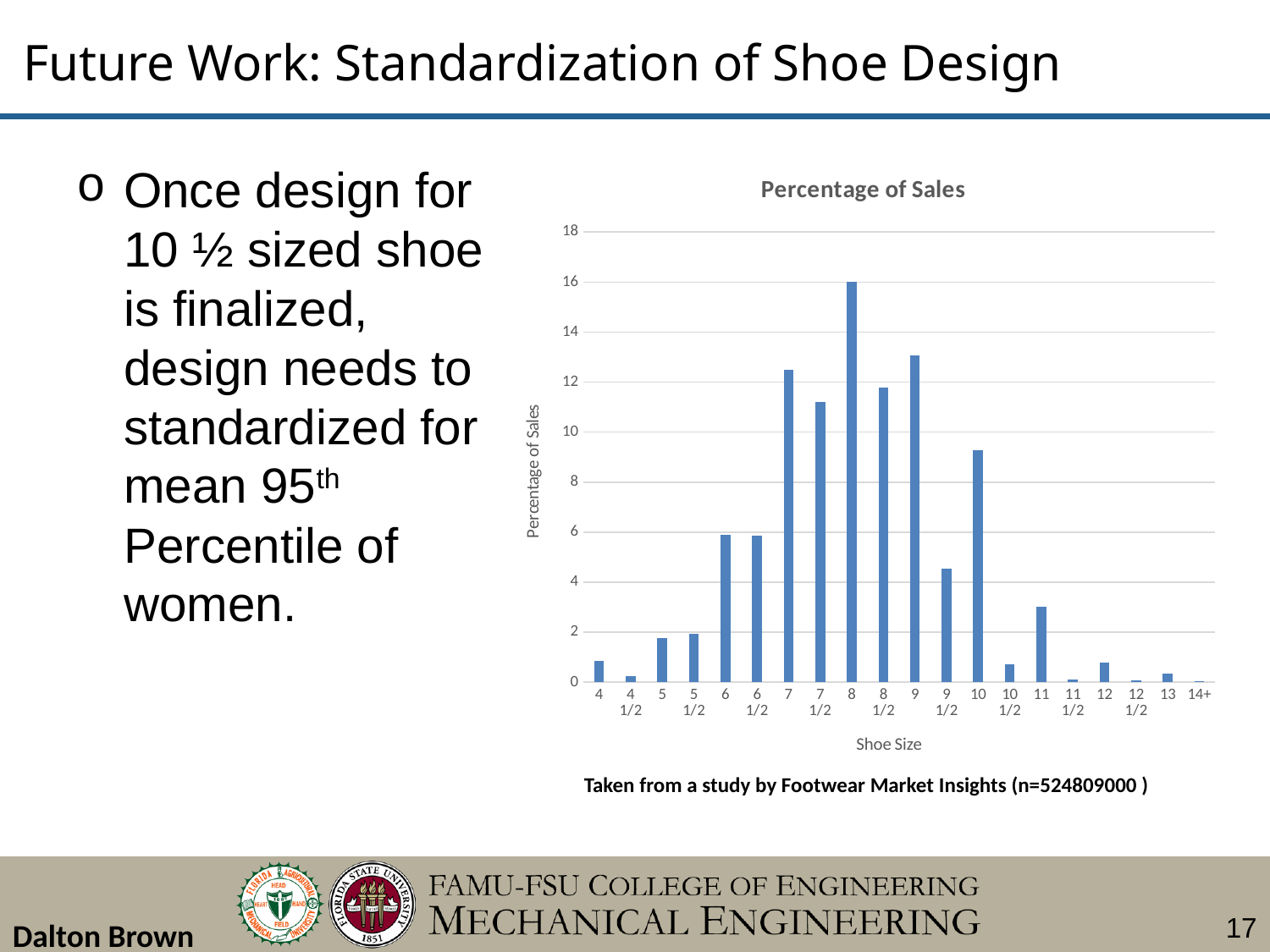
Is the value for shoe size 11 greater or less than 4? less What is the label of the x axis of the chart? Shoe Size What is the title of the chart? Percentage of Sales How many shoe size categories are shown on the x axis? 20 Is the value for shoe size 7 greater or less than 12? greater Is the value for shoe size 10 greater or less than 10? less Which shoe size has the highest percentage of sales? 8 Do the values generally rise or fall from shoe size 8 to shoe size 14+? fall Which has a higher percentage of sales, shoe size 9 or shoe size 10? 9 What kind of chart is shown on the slide? bar chart Which has a higher percentage of sales, shoe size 6 or shoe size 5? 6